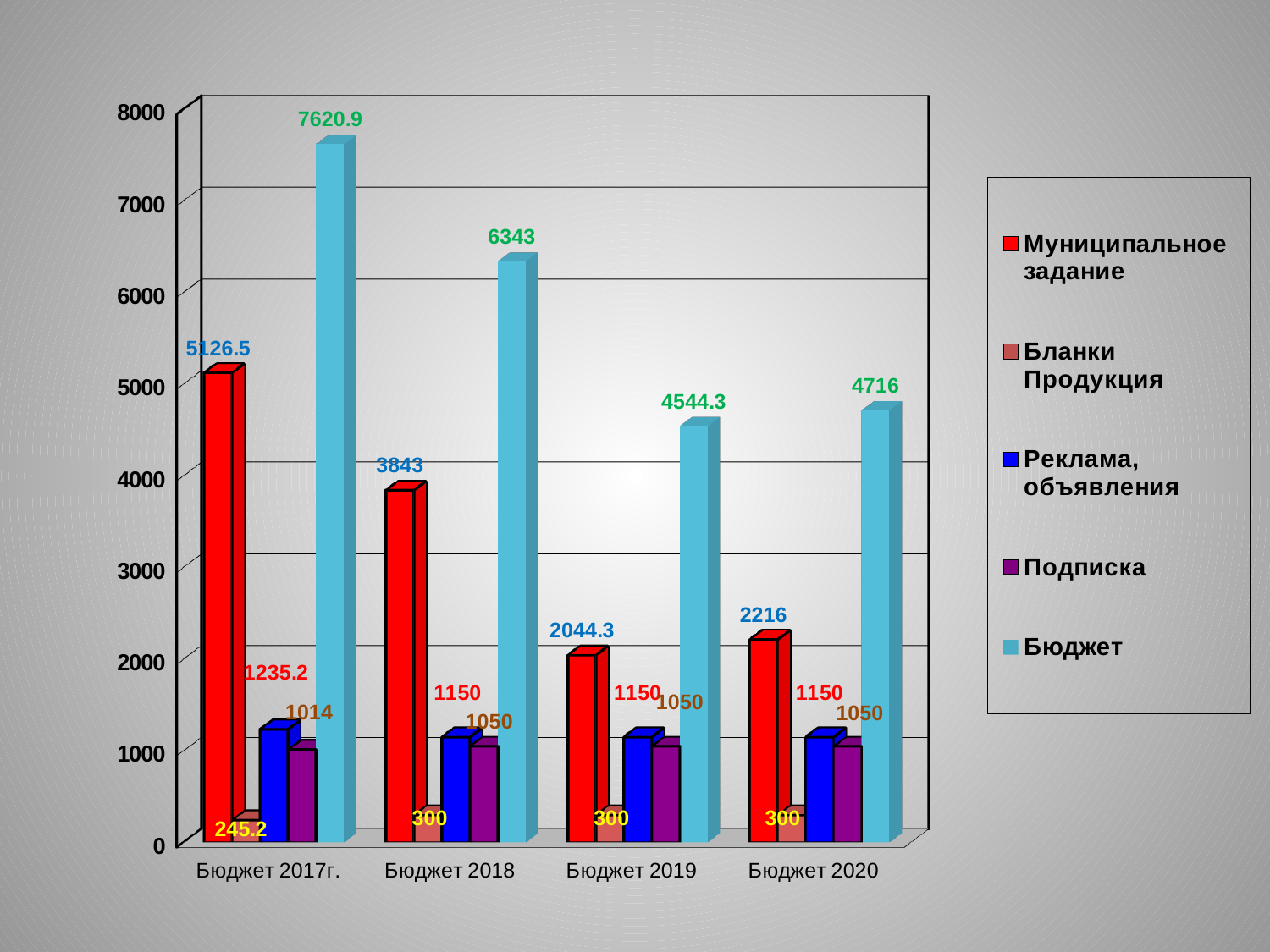
In which category is the Бюджет series highest? Бюджет 2017г. How many categories are shown on the x axis? 4 What is the difference between the Бюджет values for Бюджет 2018 and Бюджет 2019? 1798.7 Does the Муниципальное задание series rise or fall from Бюджет 2017г. to Бюджет 2019? Fall What is the value of Бюджет for Бюджет 2017г.? 7620.9 What kind of chart is shown on the slide? Bar chart In which category is the Муниципальное задание series lowest? Бюджет 2019 What is the value of Бланки Продукция for Бюджет 2017г.? 245.2 What is the value of Подписка for Бюджет 2018? 1050 What is the value of Муниципальное задание for Бюджет 2019? 2044.3 Which is larger: Муниципальное задание for Бюджет 2020 or for Бюджет 2019? Бюджет 2020 How many series does the legend list? 5